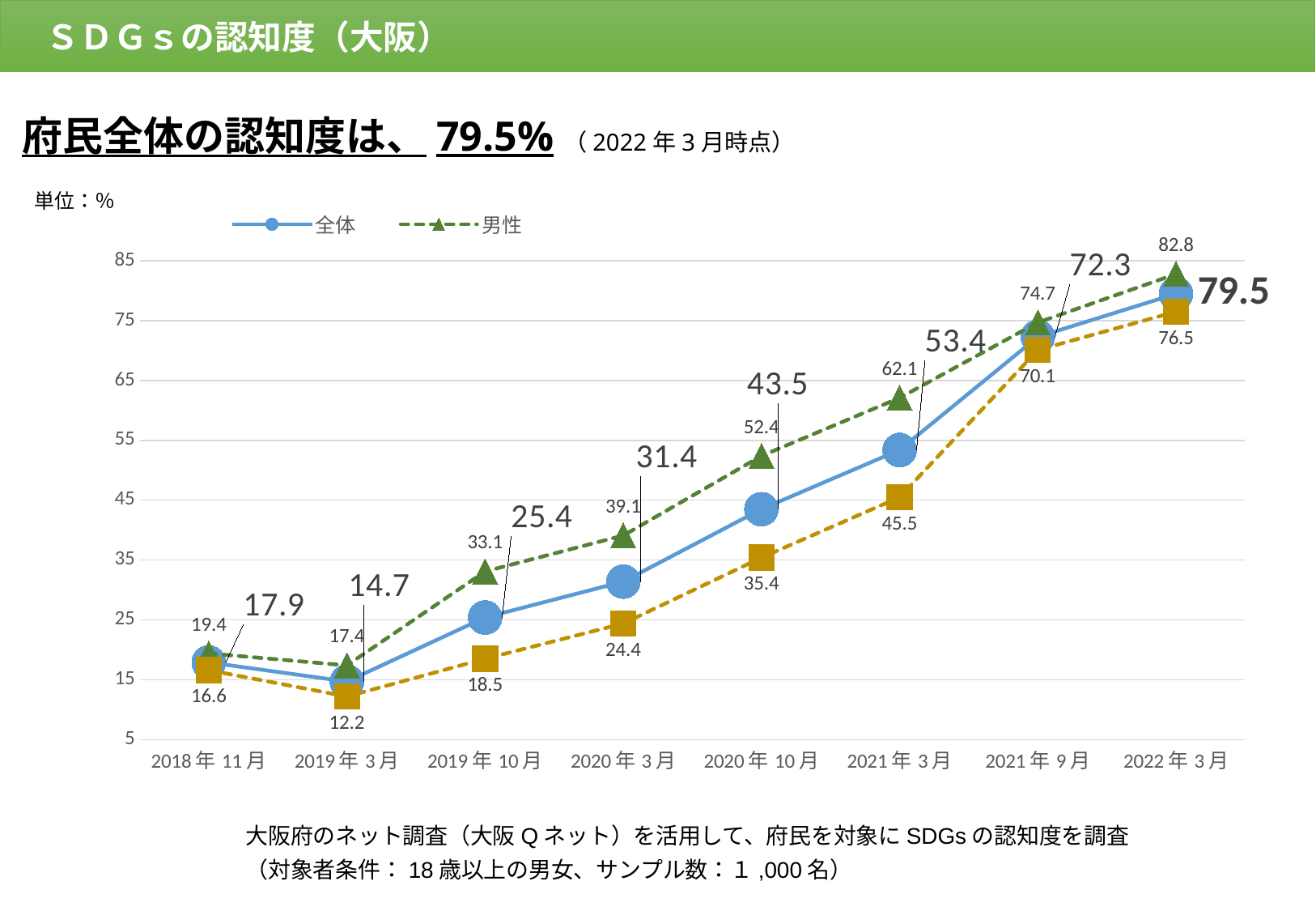
How many time periods are shown on the x axis? 8 What is the value for 全体 in 2022年3月? 79.5 What type of chart is shown on the slide? line chart In which period is the value for 全体 the lowest? 2019年3月 From 2019年3月 to 2022年3月, does the value for 全体 rise or fall? rise What is the value for 男性 in 2020年10月? 52.4 What is the difference between the 男性 value and the 全体 value in 2021年3月? 8.7 Which is larger in 2020年3月, the value for 全体 or the value for 男性? 男性 How many series does the legend list? 2 What is the value for 男性 in 2018年11月? 19.4 What is the value for 全体 in 2019年3月? 14.7 In which period is the value for 男性 the highest? 2022年3月